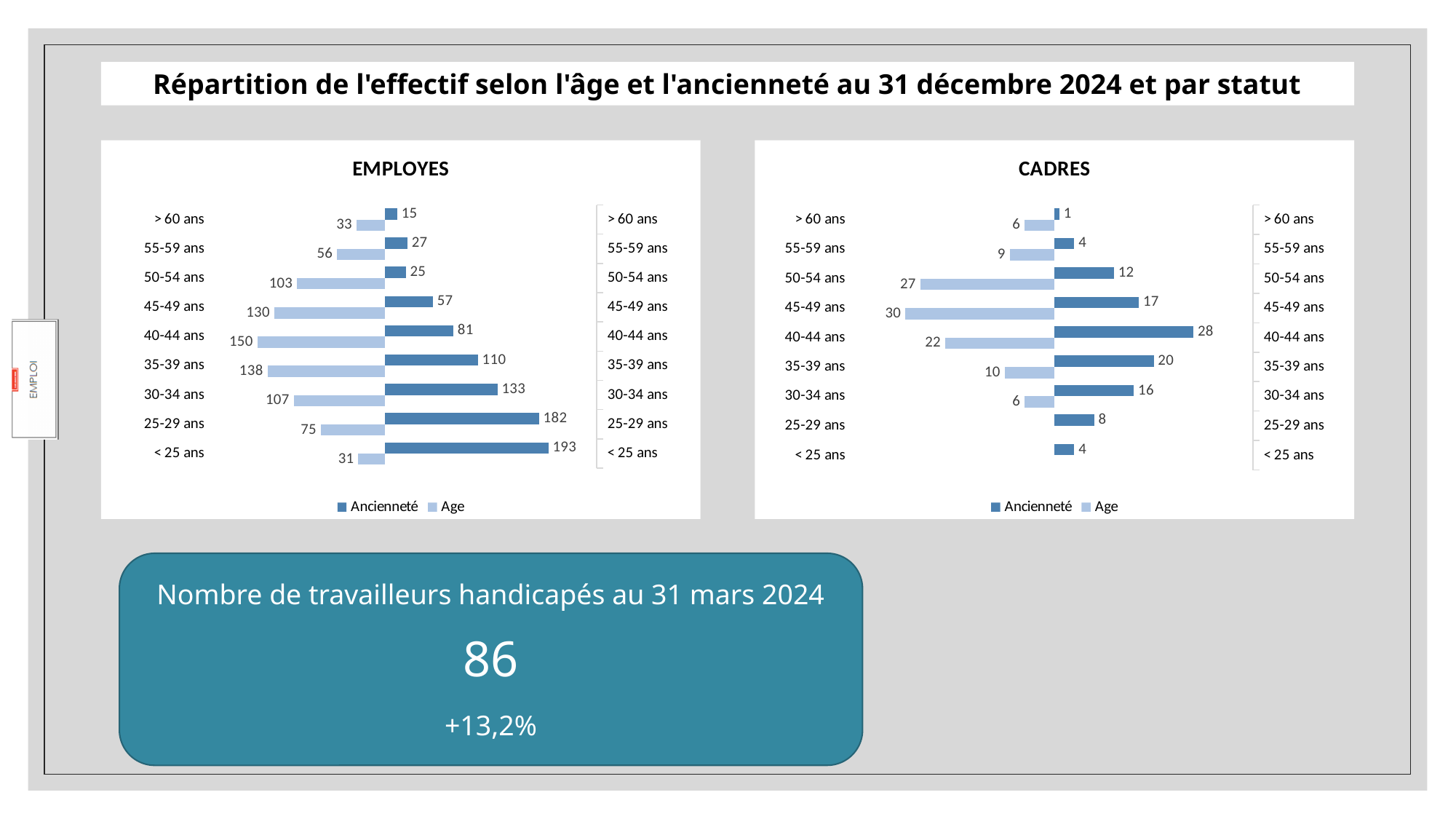
In the EMPLOYES chart, what is the difference between the Ancienneté values for 25-29 ans and 30-34 ans? 49 What kind of chart is the EMPLOYES chart? Bar chart In the CADRES chart, which age group has the highest Ancienneté value? 40-44 ans In the EMPLOYES chart, what is the Ancienneté value for < 25 ans? 193 In the CADRES chart, what is the Ancienneté value for 40-44 ans? 28 In the CADRES chart, which is larger for 50-54 ans: the Ancienneté value or the Age value? Age How many series does the legend of the CADRES chart list? 2 How many age groups are shown in the EMPLOYES chart? 9 In the CADRES chart, what is the Age value for 45-49 ans? 30 In the EMPLOYES chart, what is the Age value for 40-44 ans? 150 In the EMPLOYES chart, which age group has the highest Age value? 40-44 ans In the EMPLOYES chart, which age group has the lowest Ancienneté value? > 60 ans